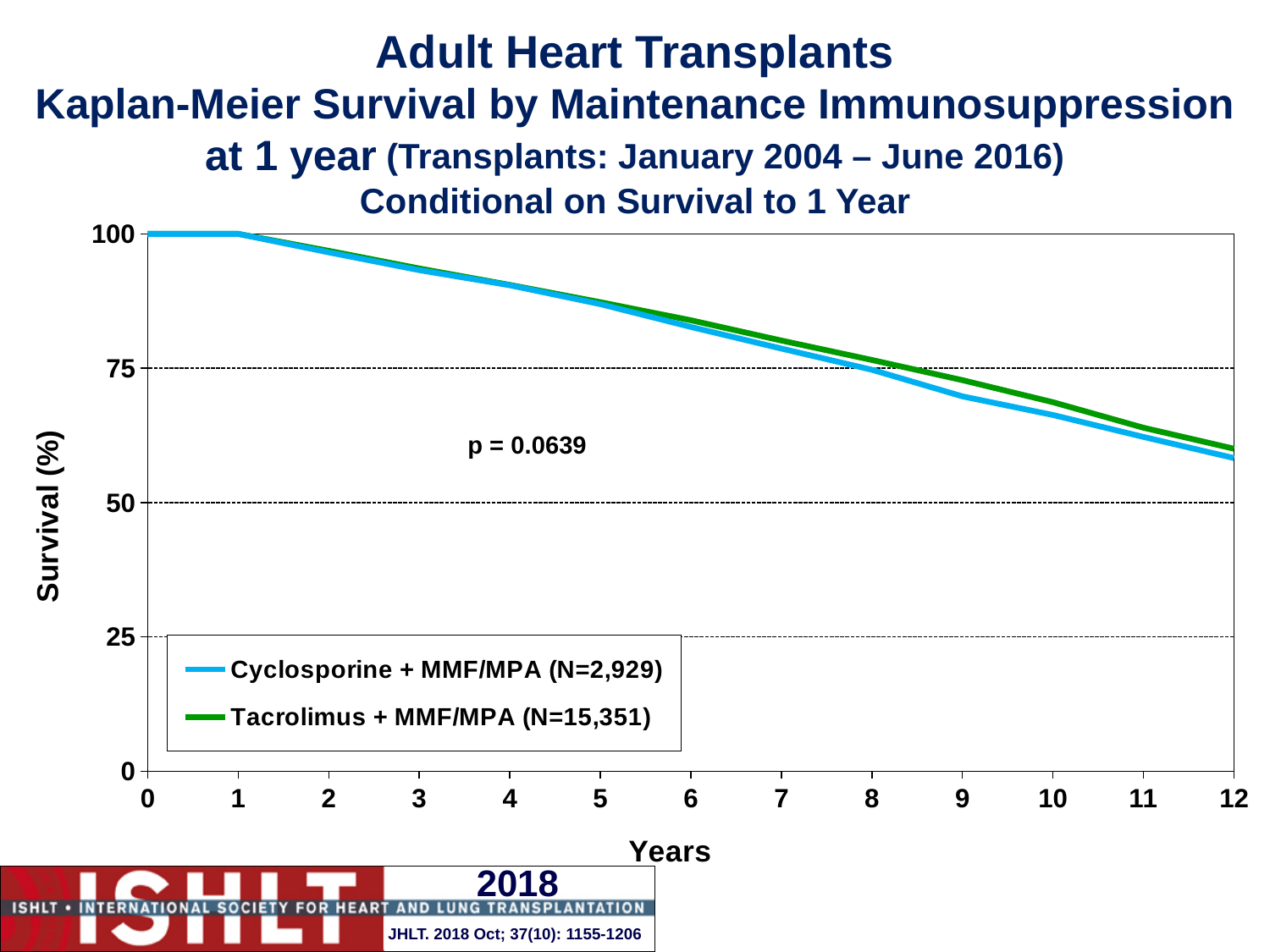
What is the N for the Tacrolimus + MMF/MPA group shown in the legend? 15,351 Is the survival value for Cyclosporine + MMF/MPA at 10 years greater or less than 75? less What is the label of the x axis? Years Is the survival value for Cyclosporine + MMF/MPA at 12 years greater or less than 75? less How many series does the legend list? 2 Is the survival value for Tacrolimus + MMF/MPA at 12 years greater or less than 50? greater What kind of chart is shown on the slide? line chart Do the survival curves rise or fall as years increase? fall At 12 years, which group has the higher survival, Cyclosporine + MMF/MPA or Tacrolimus + MMF/MPA? Tacrolimus + MMF/MPA What p-value is printed on the chart? p = 0.0639 What is the N for the Cyclosporine + MMF/MPA group shown in the legend? 2,929